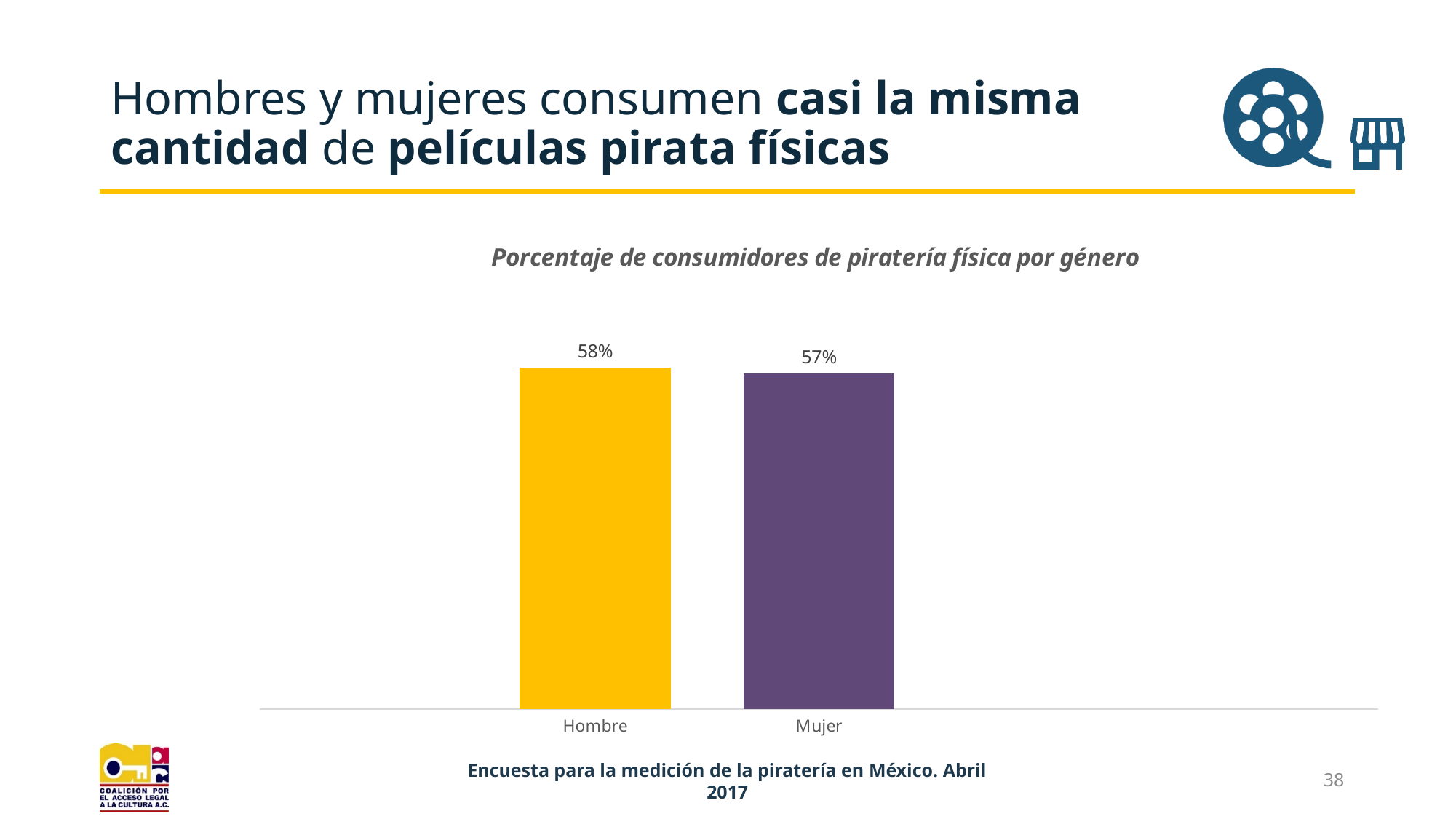
Which category has the highest value? Hombre What is the value for Mujer? 57% What is the value for Hombre? 58% How many categories are shown in the chart? 2 Which is larger, the value for Hombre or the value for Mujer? Hombre What colour is the bar for Mujer? Purple What kind of chart is shown on the slide? Bar chart Which category has the lowest value? Mujer What is the title of the chart? Porcentaje de consumidores de piratería física por género What is the difference between the values for Hombre and Mujer? 1%